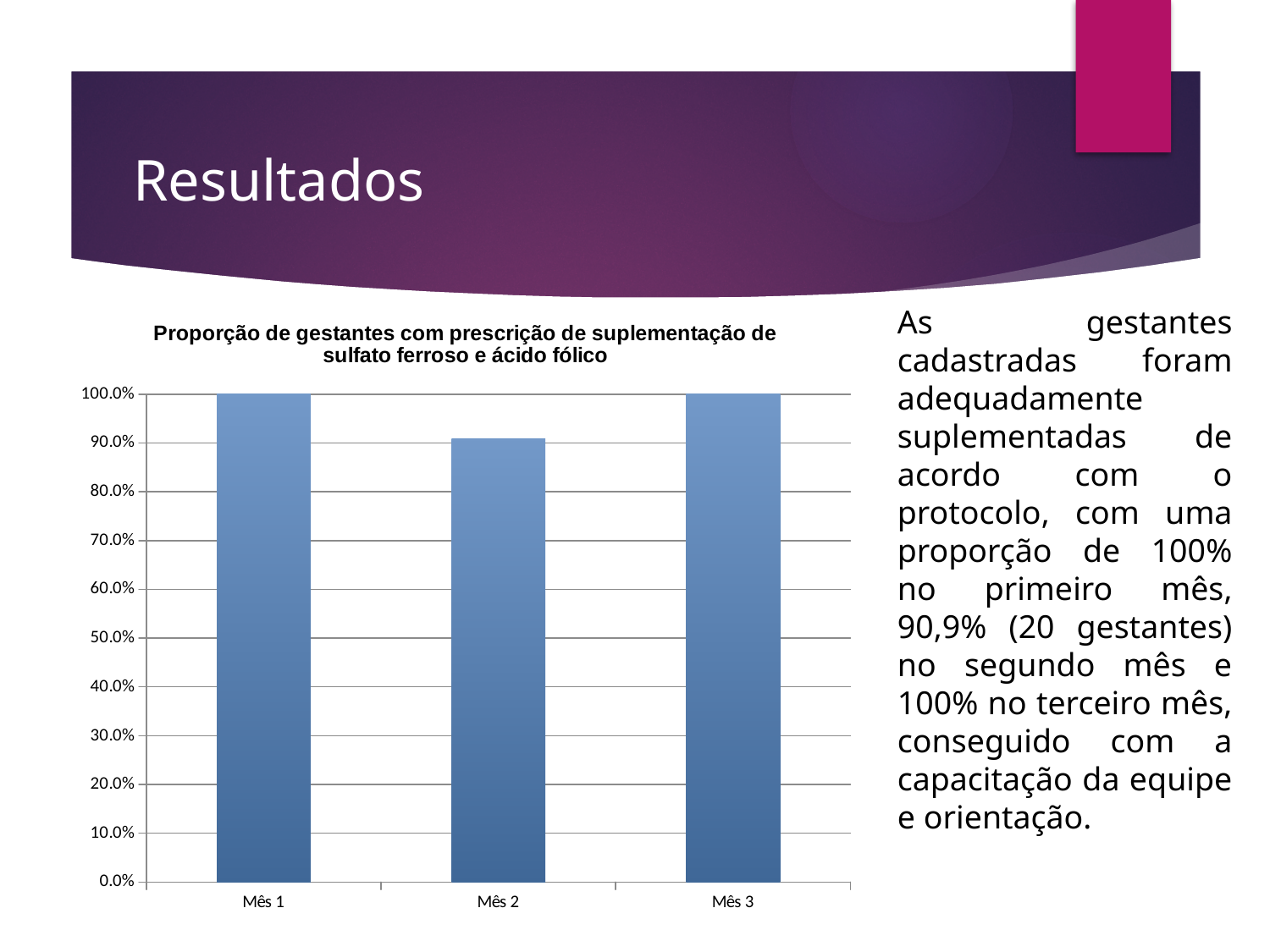
Is the value for Mês 2 greater or less than 80.0%? greater How many categories are shown on the x axis? 3 Does the value rise or fall from Mês 1 to Mês 2? fall What is the title of the chart? Proporção de gestantes com prescrição de suplementação de sulfato ferroso e ácido fólico What is the value for Mês 3? 100.0% Which is larger, the value for Mês 1 or the value for Mês 2? Mês 1 What kind of chart is shown on the slide? bar chart What is the value for Mês 1? 100.0% Which month has the lowest value? Mês 2 Is the value for Mês 2 greater or less than 100.0%? less Which is larger, the value for Mês 2 or the value for Mês 3? Mês 3 Does the value rise or fall from Mês 2 to Mês 3? rise